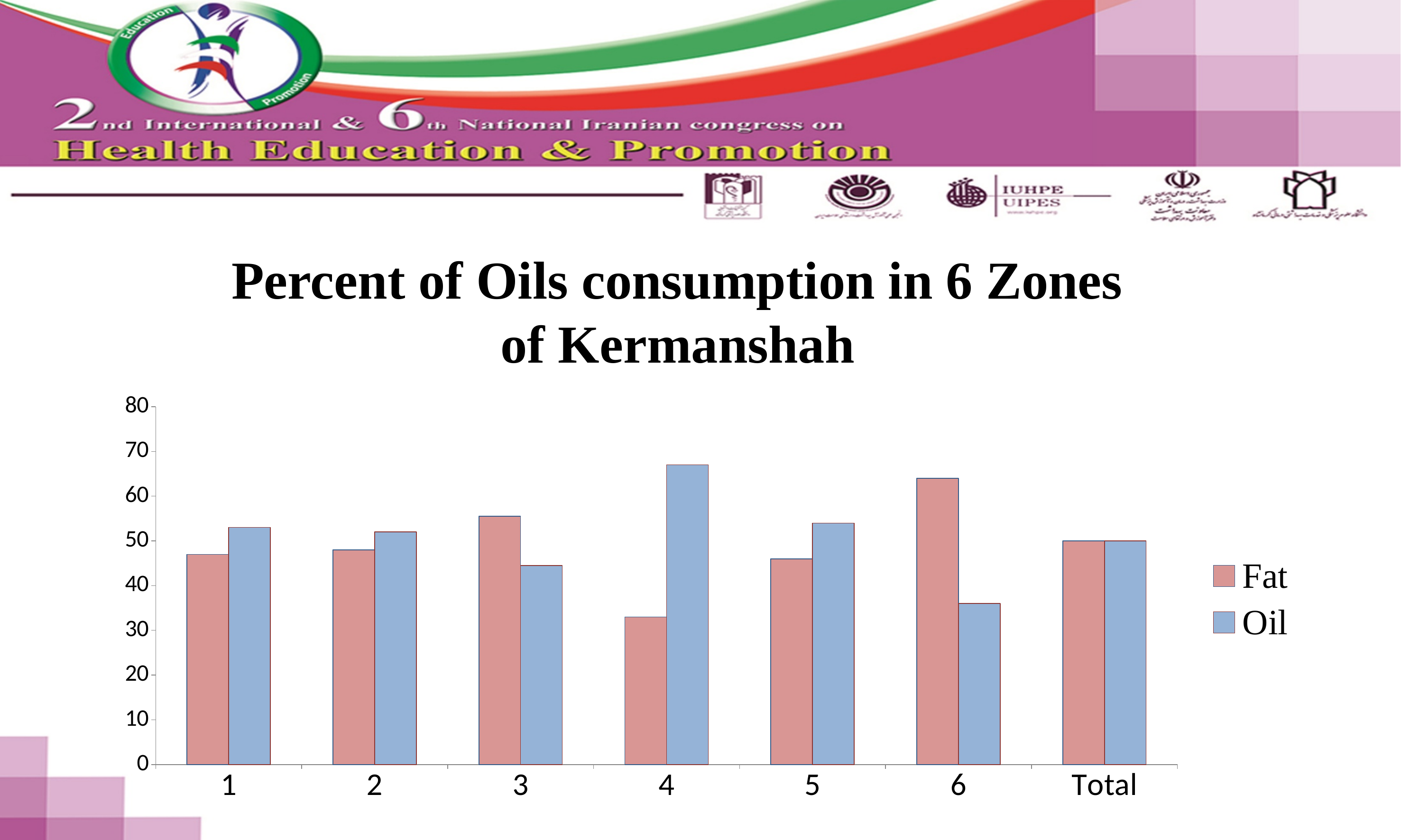
What is the title of the chart? Percent of Oils consumption in 6 Zones of Kermanshah How many series does the legend list? 2 Which zone has the highest Fat value? 6 In zone 6, which is larger, Fat or Oil? Fat Which zone has the lowest Oil value? 6 Which zone has the highest Oil value? 4 Is the Oil value for zone 4 greater or less than 60? greater In zone 4, which is larger, Fat or Oil? Oil Is the Fat value for zone 4 greater or less than 40? less How many categories are shown on the x axis? 7 What kind of chart is shown on the slide? bar chart Which zone has the lowest Fat value? 4